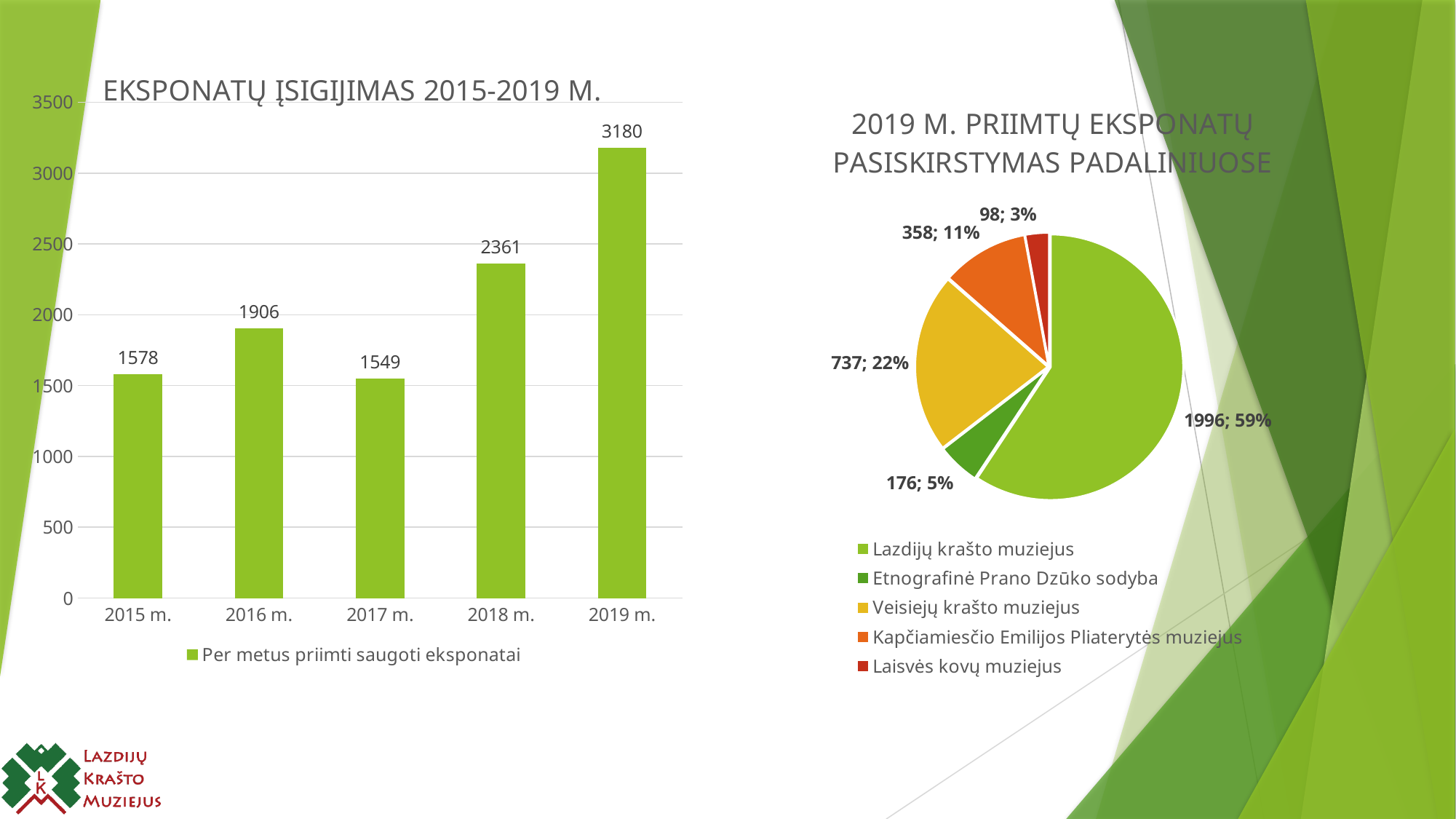
How many categories does the legend of the pie chart '2019 M. PRIIMTŲ EKSPONATŲ PASISKIRSTYMAS PADALINIUOSE' list? 5 In the bar chart 'EKSPONATŲ ĮSIGIJIMAS 2015-2019 M.', what is the value for 2018 m.? 2361 In the bar chart 'EKSPONATŲ ĮSIGIJIMAS 2015-2019 M.', how many years are shown on the x axis? 5 In the bar chart 'EKSPONATŲ ĮSIGIJIMAS 2015-2019 M.', which is larger, the value for 2015 m. or 2016 m.? 2016 m. In the pie chart '2019 M. PRIIMTŲ EKSPONATŲ PASISKIRSTYMAS PADALINIUOSE', which category has the smallest slice? Laisvės kovų muziejus In the bar chart 'EKSPONATŲ ĮSIGIJIMAS 2015-2019 M.', which year has the highest value? 2019 m. In the bar chart 'EKSPONATŲ ĮSIGIJIMAS 2015-2019 M.', what is the legend entry for the series? Per metus priimti saugoti eksponatai What kind of chart is 'EKSPONATŲ ĮSIGIJIMAS 2015-2019 M.'? bar chart In the bar chart 'EKSPONATŲ ĮSIGIJIMAS 2015-2019 M.', what is the difference between the values for 2019 m. and 2018 m.? 819 In the bar chart 'EKSPONATŲ ĮSIGIJIMAS 2015-2019 M.', which year has the lowest value? 2017 m. In the pie chart '2019 M. PRIIMTŲ EKSPONATŲ PASISKIRSTYMAS PADALINIUOSE', what share does Lazdijų krašto muziejus have? 59% In the pie chart '2019 M. PRIIMTŲ EKSPONATŲ PASISKIRSTYMAS PADALINIUOSE', what is the value for Veisiejų krašto muziejus? 737